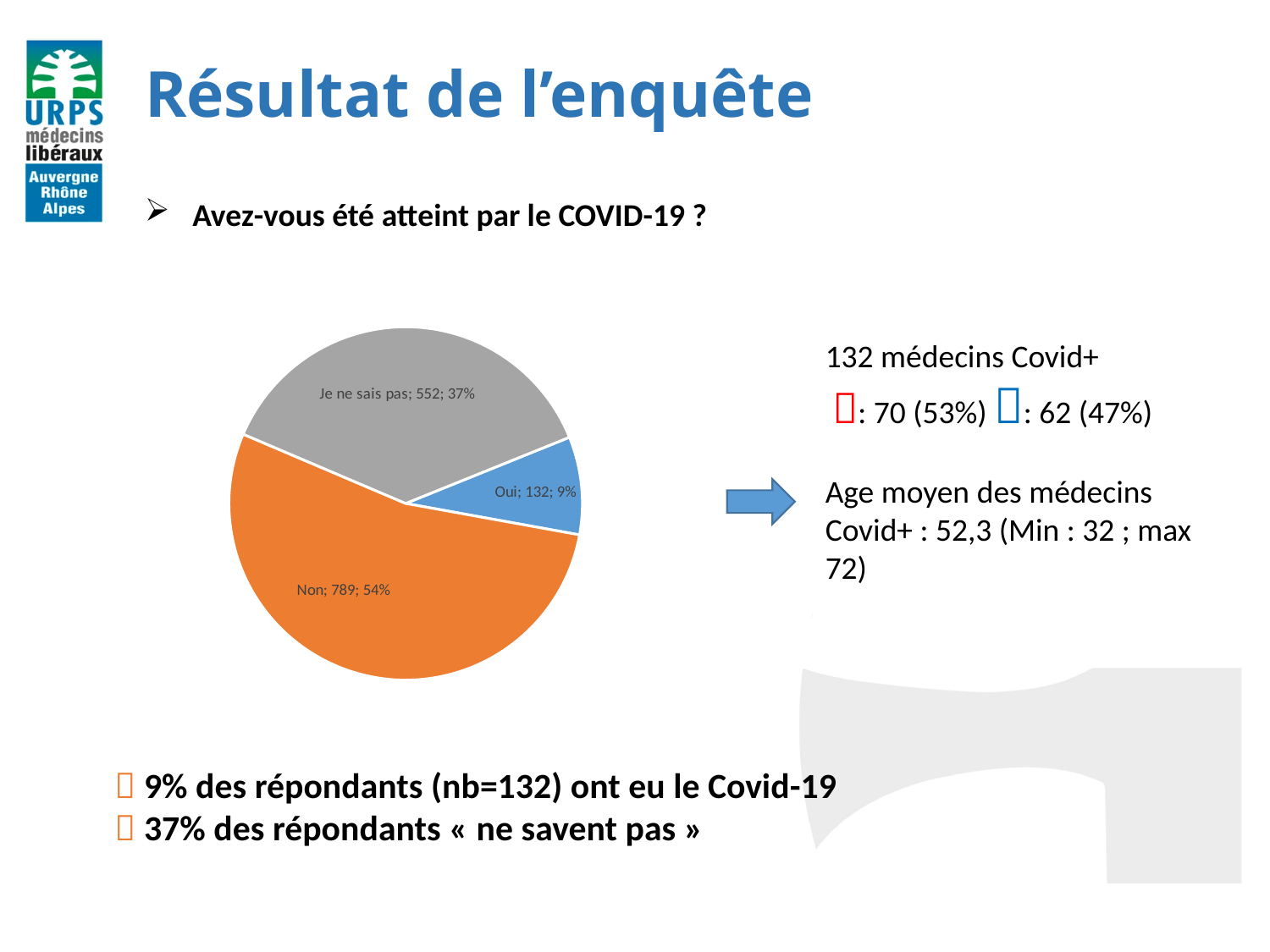
What kind of chart is shown on the slide? pie chart Which category has the smallest slice in the pie chart? Oui How many slices does the pie chart have? 3 What is the value for "Oui" in the pie chart? 132 Which colour is used for the "Oui" slice in the pie chart? blue What is the value for "Je ne sais pas" in the pie chart? 552 What is the value for "Non" in the pie chart? 789 What is the difference between the values for "Non" and "Je ne sais pas"? 237 What share of the pie does the "Oui" slice represent? 9% Which category has the largest slice in the pie chart? Non What share of the pie does the "Non" slice represent? 54% What share of the pie does the "Je ne sais pas" slice represent? 37%